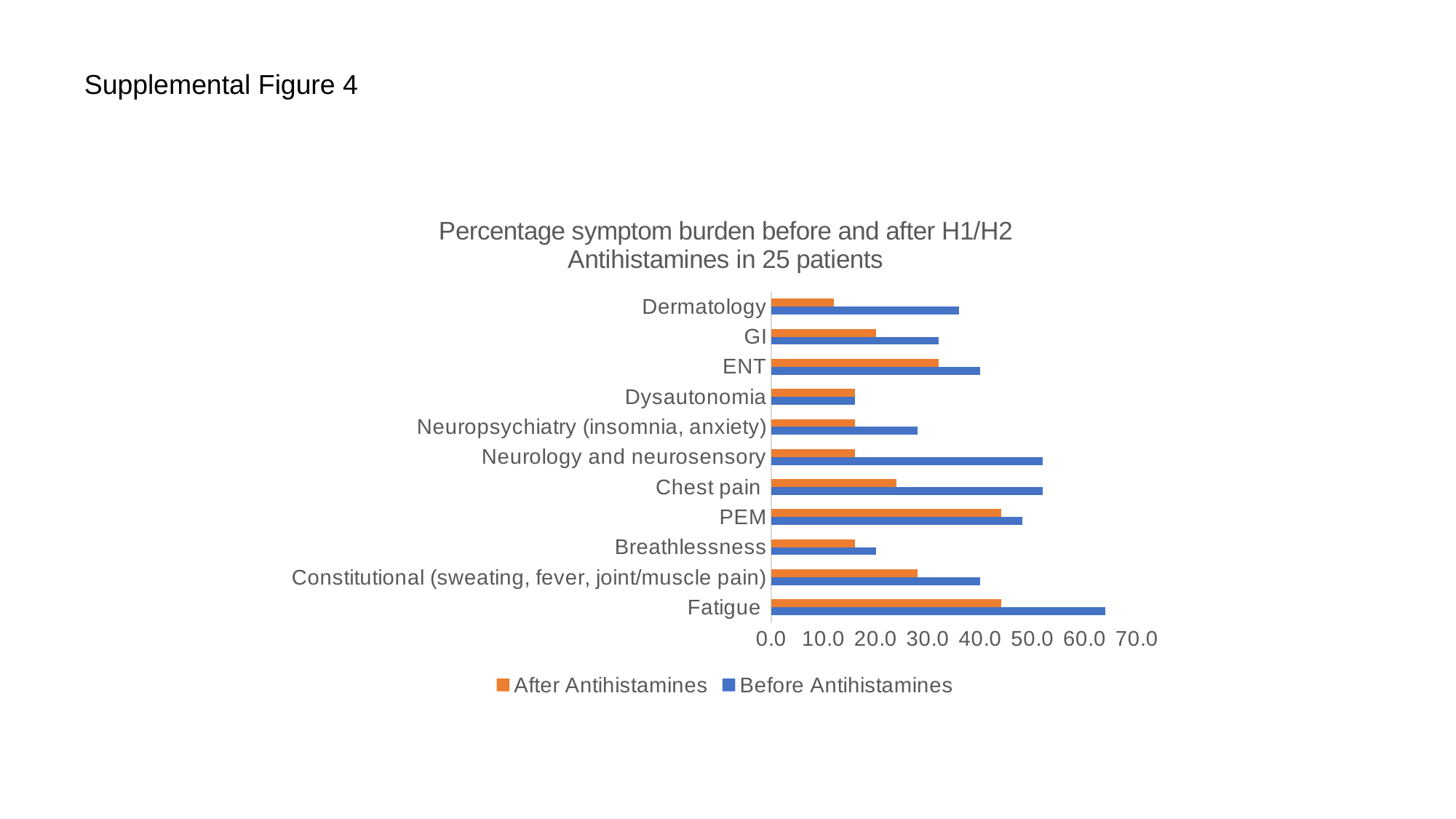
Is the After Antihistamines value for Chest pain greater or less than 20.0? greater How many series does the legend list? 2 Is the After Antihistamines value for GI greater or less than 30.0? less Which colour represents the After Antihistamines series in the legend? Orange Is the Before Antihistamines value for Fatigue greater or less than 60.0? greater Which symptom category has the lowest After Antihistamines value? Dermatology Which is larger: the After Antihistamines value for ENT or the After Antihistamines value for GI? ENT For Fatigue, which is larger: the Before Antihistamines value or the After Antihistamines value? Before Antihistamines What kind of chart is shown on the slide? Bar chart How many symptom categories are plotted on the chart? 11 Which symptom category has the highest Before Antihistamines value? Fatigue